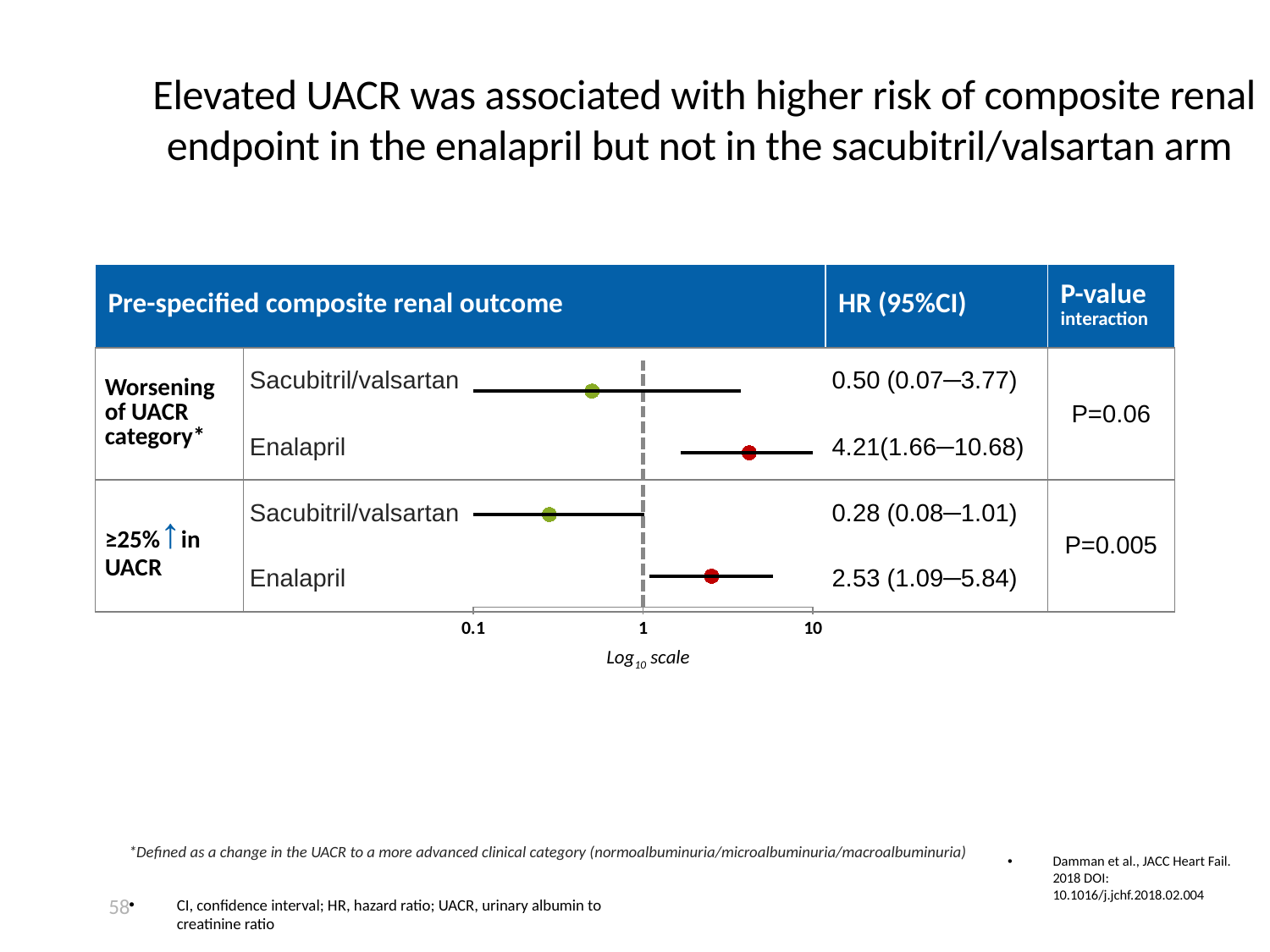
What is the HR (95%CI) for Enalapril in the ≥25% increase in UACR row? 2.53 (1.09–5.84) What is the P-value for interaction for the ≥25% increase in UACR outcome? P=0.005 What is the P-value for interaction for the Worsening of UACR category outcome? P=0.06 What is the HR (95%CI) for Sacubitril/valsartan in the Worsening of UACR category row? 0.50 (0.07–3.77) Which treatment and outcome row has the lowest hazard ratio point estimate? Sacubitril/valsartan, ≥25% increase in UACR (0.28) What is the difference between the hazard ratio point estimates for Enalapril and Sacubitril/valsartan in the Worsening of UACR category row? 3.71 What is the HR (95%CI) for Sacubitril/valsartan in the ≥25% increase in UACR row? 0.28 (0.08–1.01) How many hazard ratio point estimates are plotted in the forest plot? 4 What is the HR (95%CI) for Enalapril in the Worsening of UACR category row? 4.21 (1.66–10.68) What scale is used on the x axis of the forest plot? Log10 scale Which treatment and outcome row has the highest hazard ratio point estimate? Enalapril, Worsening of UACR category (4.21) For the ≥25% increase in UACR outcome, which arm has the larger hazard ratio, Sacubitril/valsartan or Enalapril? Enalapril